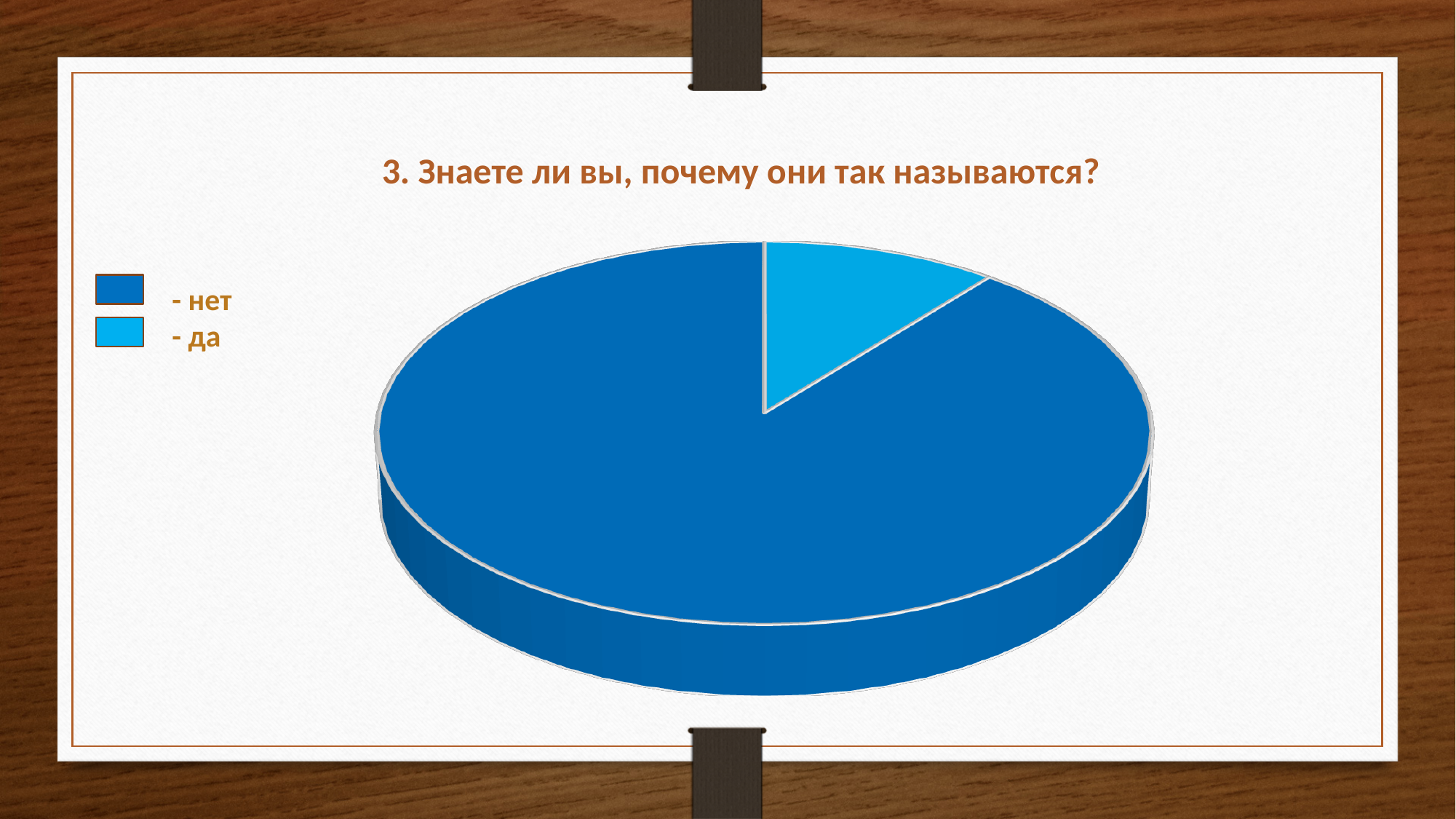
Which colour represents the "да" category in the legend? light blue What is the title of the chart? 3. Знаете ли вы, почему они так называются? How many slices does the pie chart have? 2 Which category has the largest slice of the pie? нет Which category has the smallest slice of the pie? да How many entries does the legend list? 2 Which slice is larger, "нет" or "да"? нет What kind of chart is shown on the slide? pie chart